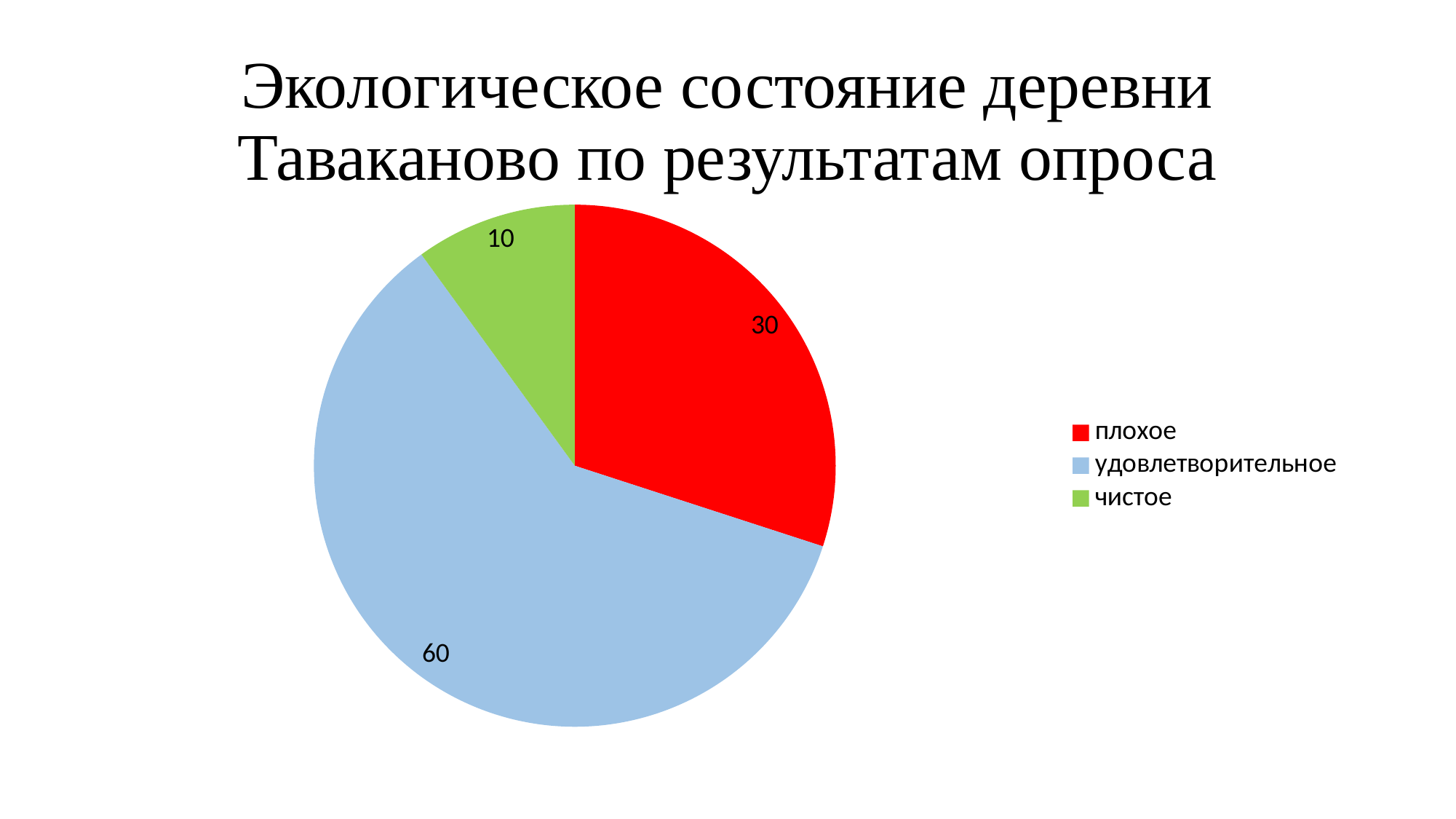
How many categories does the pie chart have? 3 What is the title of the slide? Экологическое состояние деревни Таваканово по результатам опроса What share of the pie does the плохое slice represent? 30% Which category has the smallest slice? чистое What kind of chart is shown on the slide? pie chart What is the value for чистое? 10 What is the value for плохое? 30 Which category has the largest slice? удовлетворительное What colour is the slice for удовлетворительное? light blue What is the difference between the values for удовлетворительное and плохое? 30 What is the value for удовлетворительное? 60 Which is larger, the value for плохое or the value for чистое? плохое